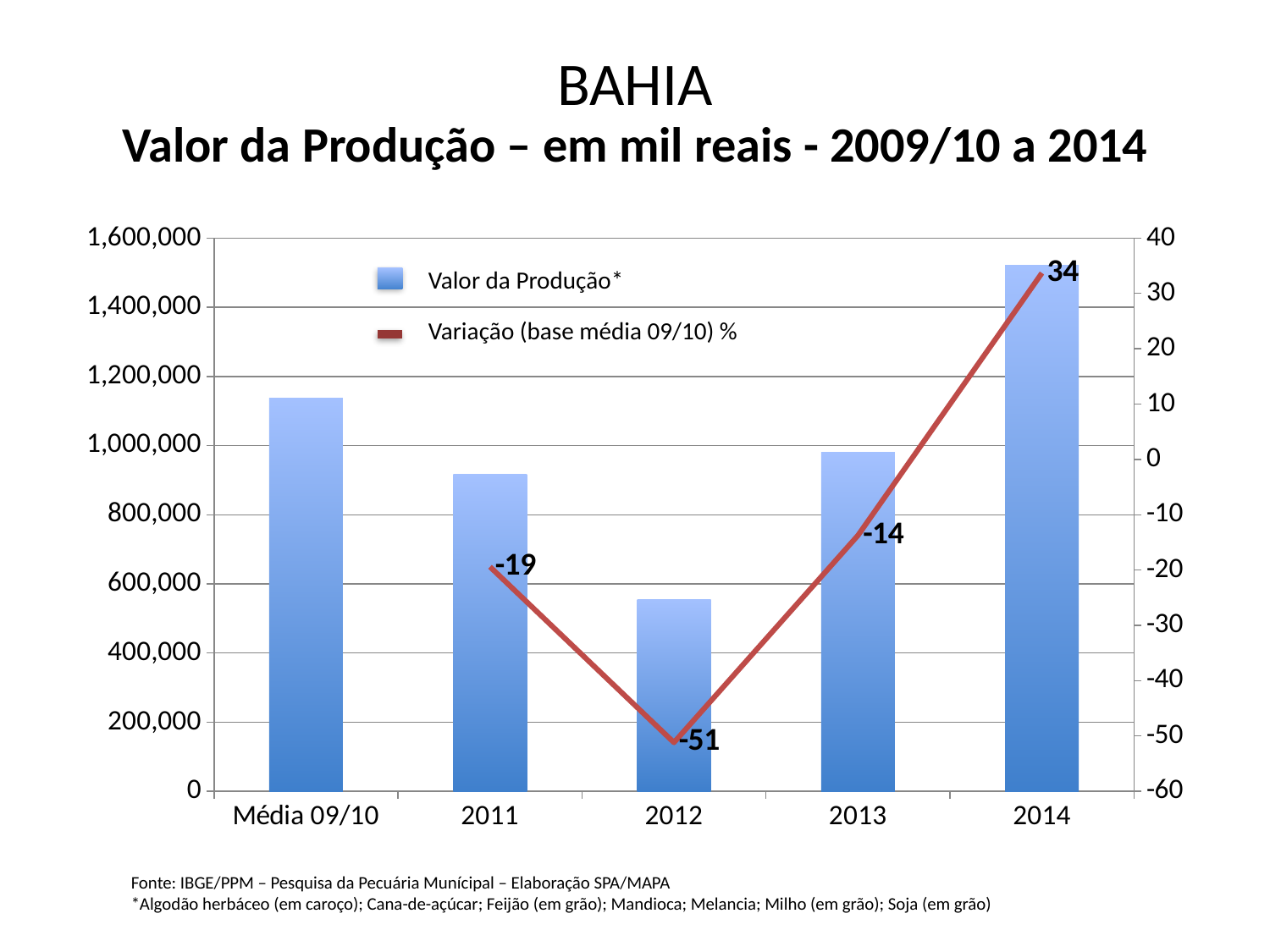
How many categories are shown on the x axis? 5 Which is larger, the Valor da Produção* bar for 2013 or for 2011? 2013 How many series does the legend list? 2 What is the difference between the Variação values for 2014 and 2012? 85 What is the value of the Variação (base média 09/10) % line for 2014? 34 What is the value of the Variação (base média 09/10) % line for 2011? -19 Which category has the lowest Valor da Produção* bar? 2012 Is the Valor da Produção* value for 2014 greater or less than 1,400,000? greater Which category has the highest Valor da Produção* bar? 2014 Is the Valor da Produção* value for 2012 greater or less than 600,000? less What is the value of the Variação (base média 09/10) % line for 2012? -51 What is the value of the Variação (base média 09/10) % line for 2013? -14